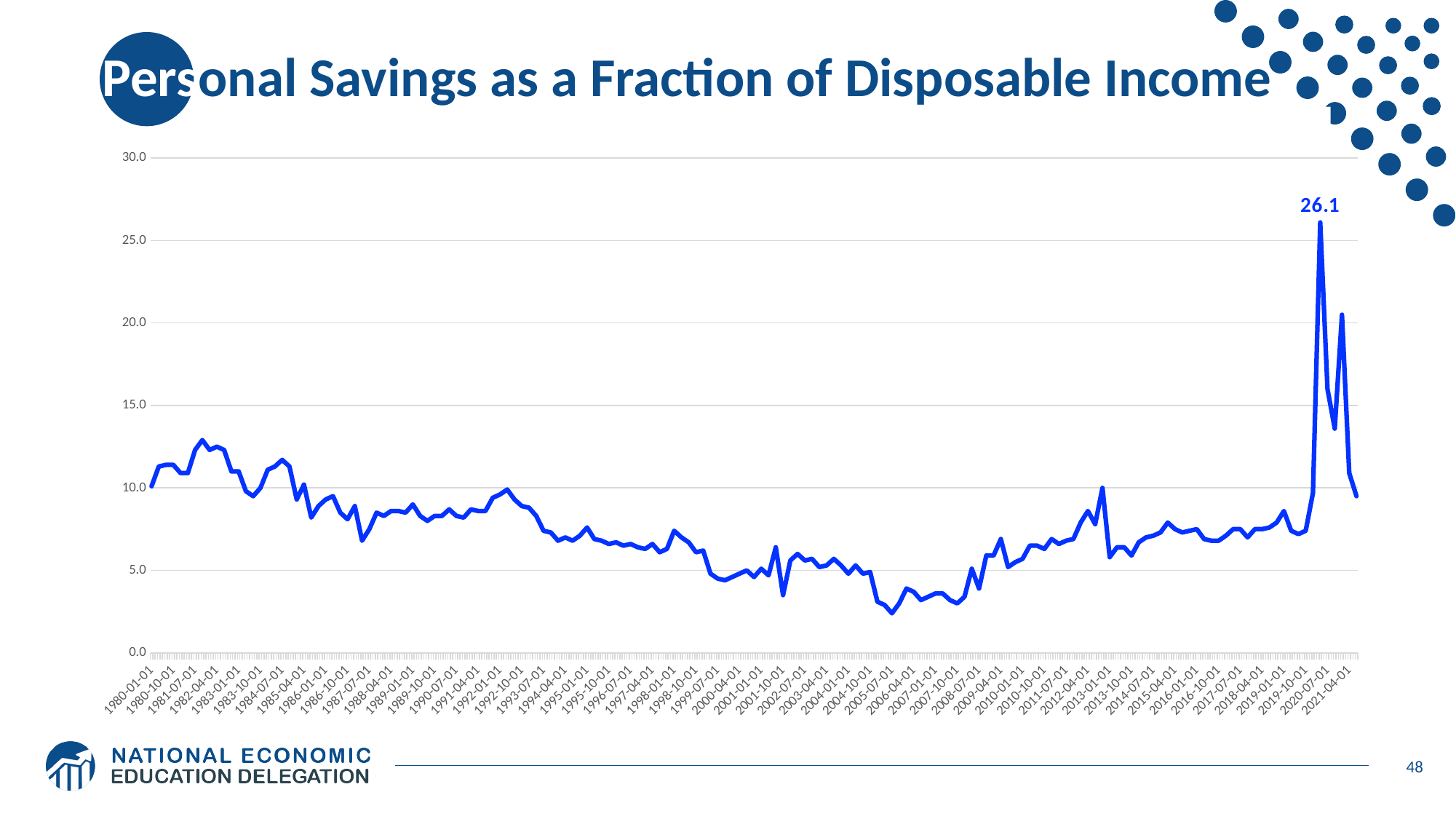
Is the peak value of the line greater or less than 25.0? greater How many lines are plotted on the chart? 1 What is the title of the chart? Personal Savings as a Fraction of Disposable Income What kind of chart is shown on the slide? line chart Overall, do the values rise or fall between 2005-07-01 and 2019-01-01? rise Which is larger, the value around 1982-04-01 or the value around 2005-07-01? 1982-04-01 Overall, do the values rise or fall between 1980-01-01 and 2005-07-01? fall Is the value around 2005-07-01 greater or less than 5.0? less What is the highest value labeled on the chart? 26.1 Is the value around 1982-04-01 greater or less than 10.0? greater What is the highest value shown on the y axis? 30.0